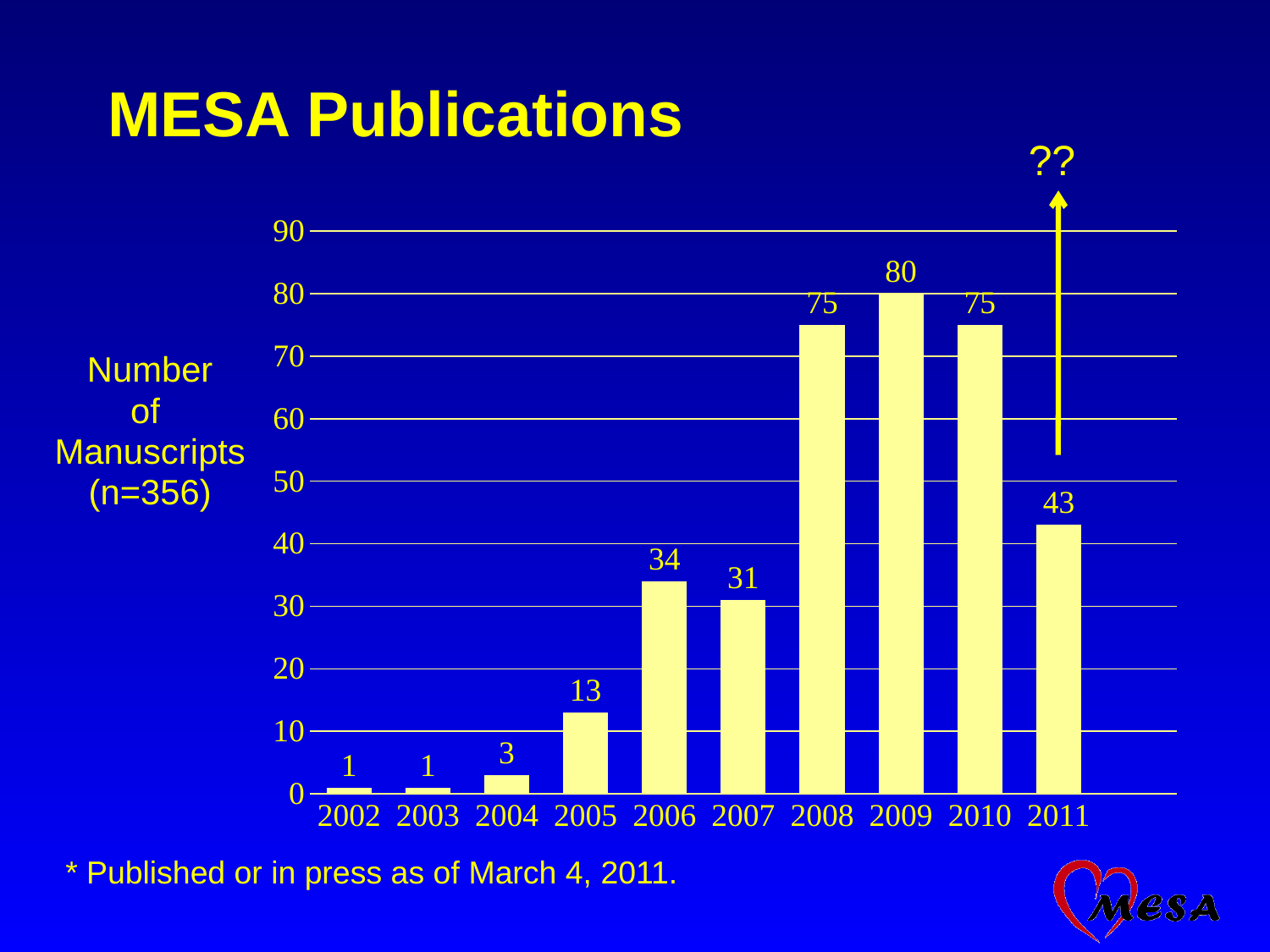
How many years are shown on the x axis? 10 Do the values generally rise or fall from 2002 to 2009? rise What is the total number of manuscripts given in the y-axis label? n=356 Is the value for 2011 greater or less than 50? less What is the title of the slide? MESA Publications Which year has the highest number of manuscripts? 2009 What is the number of manuscripts for 2005? 13 What is the difference in number of manuscripts between 2008 and 2007? 44 What is the number of manuscripts for 2009? 80 What kind of chart is shown on the slide? bar chart What is the number of manuscripts for 2011? 43 Which year has more manuscripts, 2006 or 2007? 2006